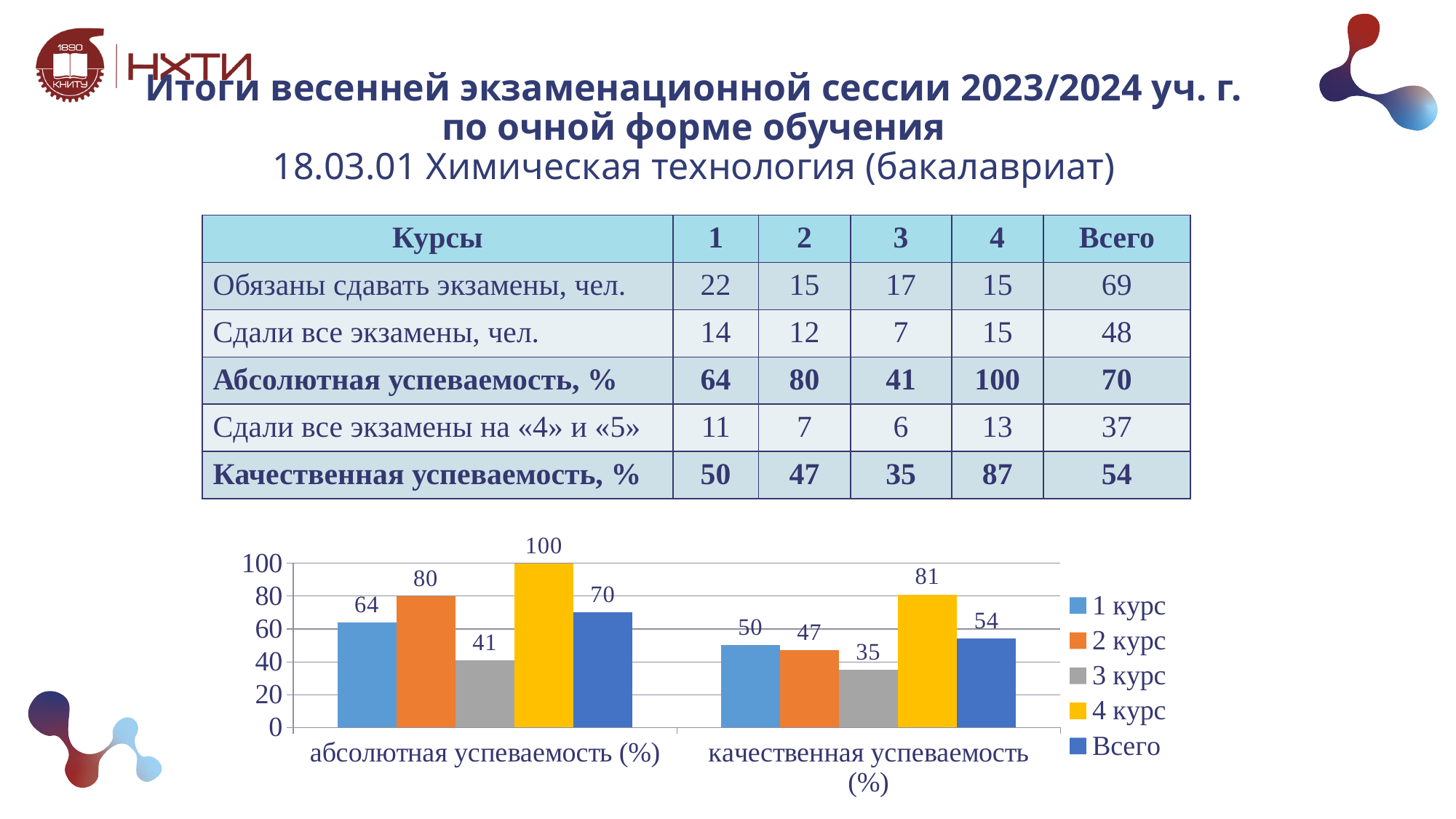
What is the value for 3 курс in the качественная успеваемость (%) group? 35 What is the difference between the 2 курс and 1 курс values in the абсолютная успеваемость (%) group? 16 What type of chart is shown on the slide? bar chart What colour are the bars for 4 курс in the chart? yellow What is the difference between the Всего values for абсолютная успеваемость (%) and качественная успеваемость (%)? 16 Which is larger in the качественная успеваемость (%) group: 1 курс or 2 курс? 1 курс How many category groups are shown on the x axis of the chart? 2 Which series has the lowest value in the абсолютная успеваемость (%) group? 3 курс How many series does the chart legend list? 5 What is the value for 4 курс in the абсолютная успеваемость (%) group? 100 What is the value for Всего in the абсолютная успеваемость (%) group? 70 Which series has the highest value in the качественная успеваемость (%) group? 4 курс